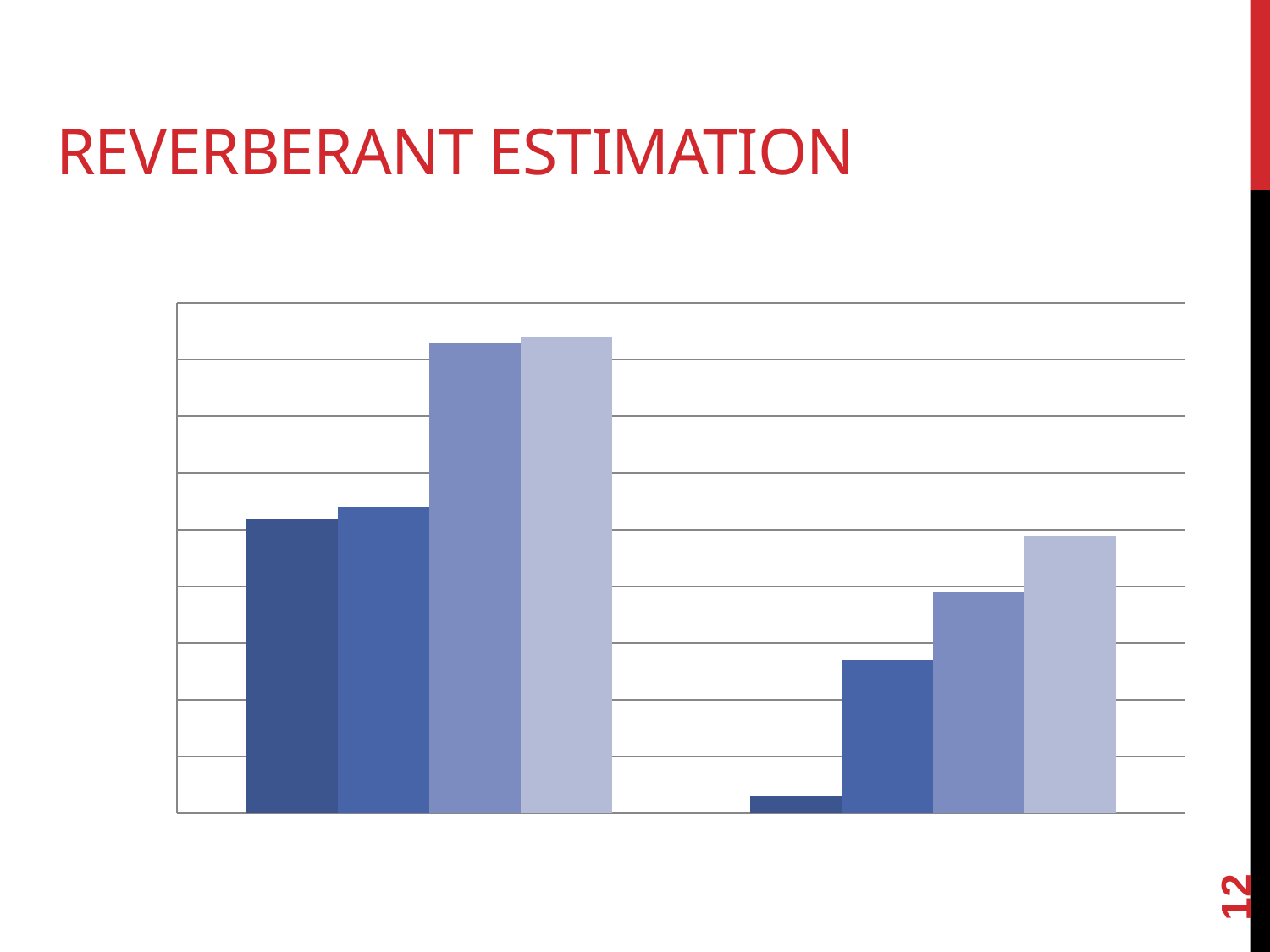
Which group of bars, left or right, contains the shortest bar in the chart? right What is the title shown on the slide above the chart? REVERBERANT ESTIMATION How many groups of bars does the chart contain? 2 How many bars are plotted in the chart in total? 8 Is the lightest blue bar in the left group taller or shorter than the lightest blue bar in the right group? taller What kind of chart is shown on the slide? bar chart Within the left group, do the bars rise or fall from left to right? rise Does the chart display a legend? No Within the right group, do the bars rise or fall from left to right? rise How many bars are in each group of the chart? 4 Which group of bars, left or right, contains the tallest bar in the chart? left Is the darkest blue bar in the left group taller or shorter than the darkest blue bar in the right group? taller